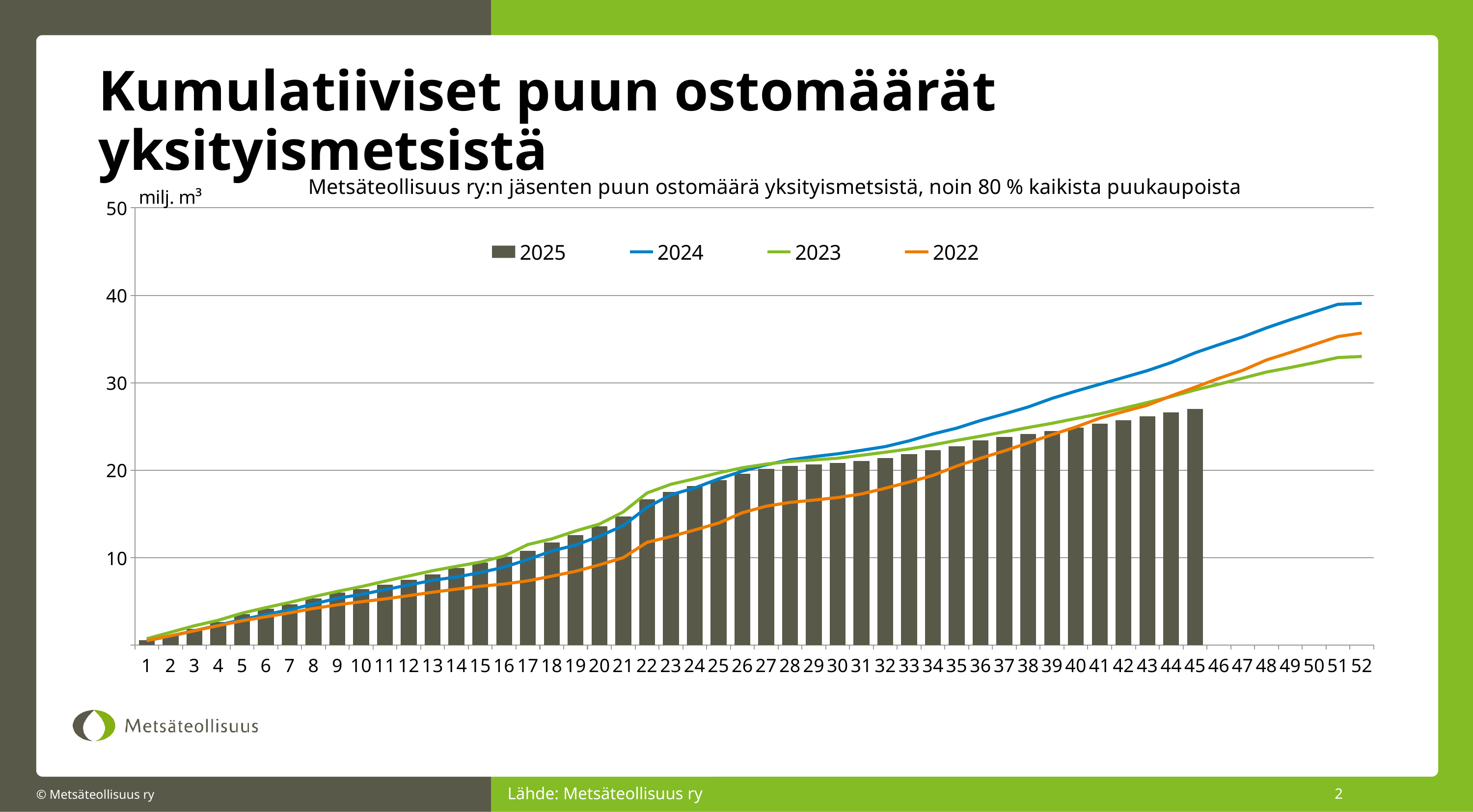
Up to which week do the 2025 bars extend? 45 What unit is shown on the y axis? milj. m³ What kind of chart is shown on the slide? Combined bar and line chart How many week categories are shown on the x axis? 52 Is the value of the 2025 bar at week 45 greater or less than 30? less Is the value of the 2024 line at week 52 greater or less than 30? greater At week 52, which is larger: the 2024 line or the 2023 line? 2024 How many series does the chart legend list? 4 Which series has the highest value at week 52? 2024 Is the value of the 2022 line at week 30 greater or less than 20? less Which series has the lowest value at week 30? 2022 Do the values for each series rise or fall along the x axis? Rise